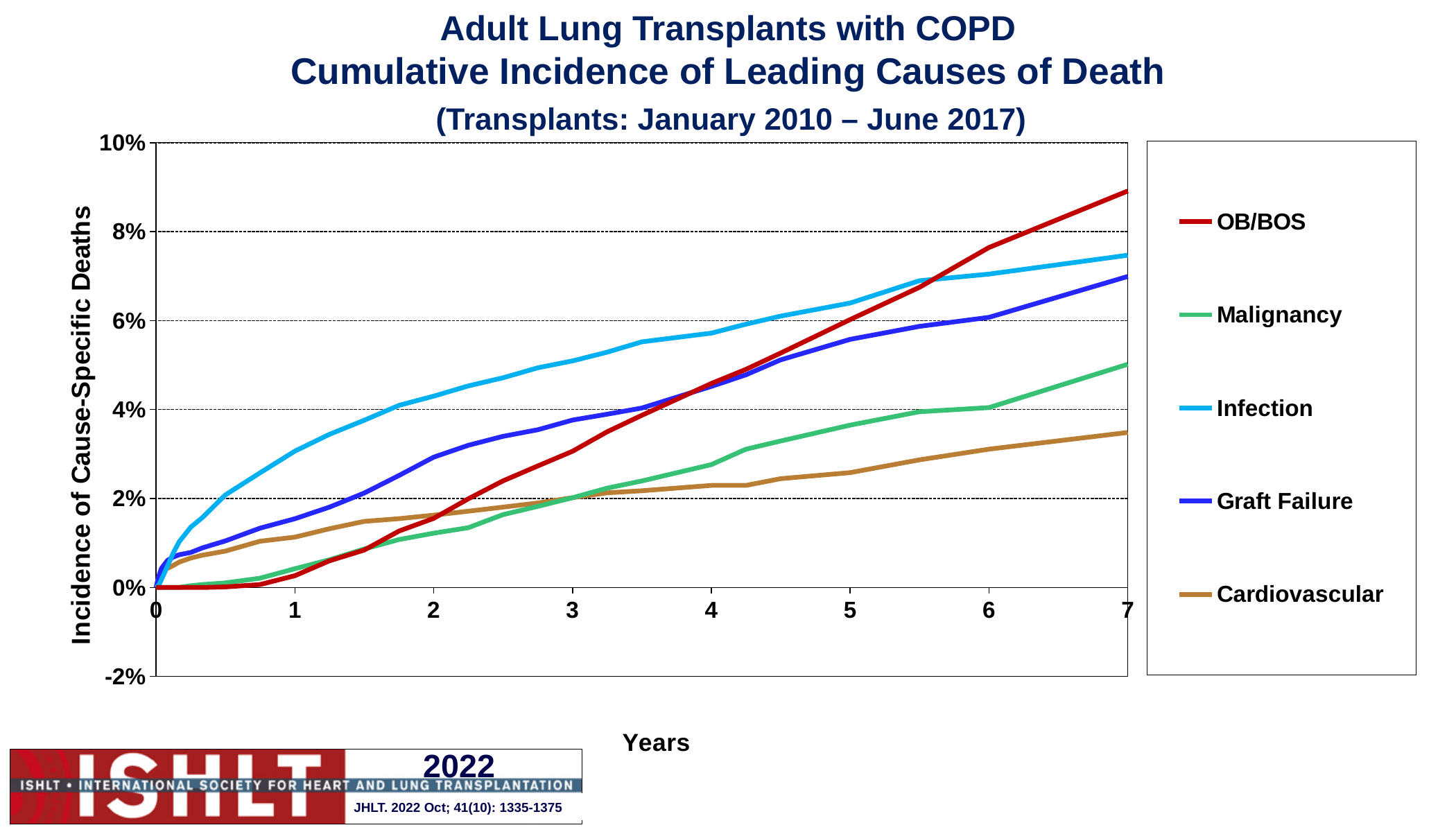
How many series does the legend list? 5 Which cause of death has the highest cumulative incidence at year 7? OB/BOS Is the value for OB/BOS at year 7 greater or less than 8%? greater Which cause of death has the highest cumulative incidence at year 1? Infection Is the value for Cardiovascular at year 7 greater or less than 4%? less Does the OB/BOS line rise or fall as years increase? rise What colour is the Infection line in the legend? light blue What kind of chart is shown on the slide? line chart Which cause of death has the lowest cumulative incidence at year 7? Cardiovascular At year 7, which is larger: Malignancy or Cardiovascular? Malignancy Is the value for OB/BOS at year 1 greater or less than 2%? less